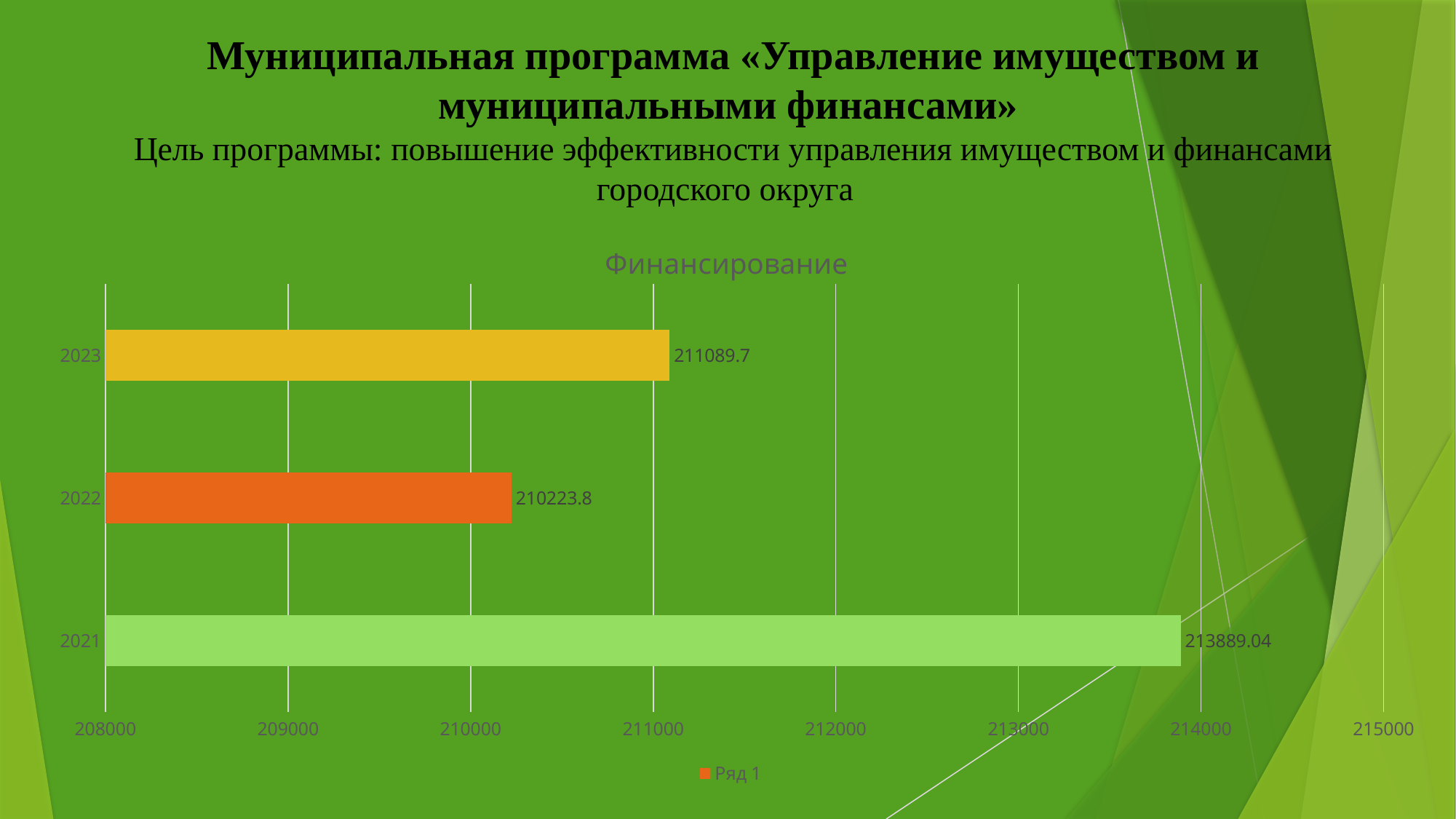
Is the value for 2021 in the Финансирование chart greater or less than 213000? greater How many years are shown in the Финансирование chart? 3 What is the difference between the values for 2023 and 2022 in the Финансирование chart? 865.9 Which year has the lowest value in the Финансирование chart? 2022 What is the value for 2021 in the Финансирование chart? 213889.04 What is the value for 2023 in the Финансирование chart? 211089.7 What kind of chart is the Финансирование chart? bar chart Which is larger in the Финансирование chart, the value for 2022 or the value for 2023? 2023 What is the legend entry shown below the Финансирование chart? Ряд 1 Which year has the highest value in the Финансирование chart? 2021 What is the difference between the values for 2021 and 2023 in the Финансирование chart? 2799.34 What is the value for 2022 in the Финансирование chart? 210223.8